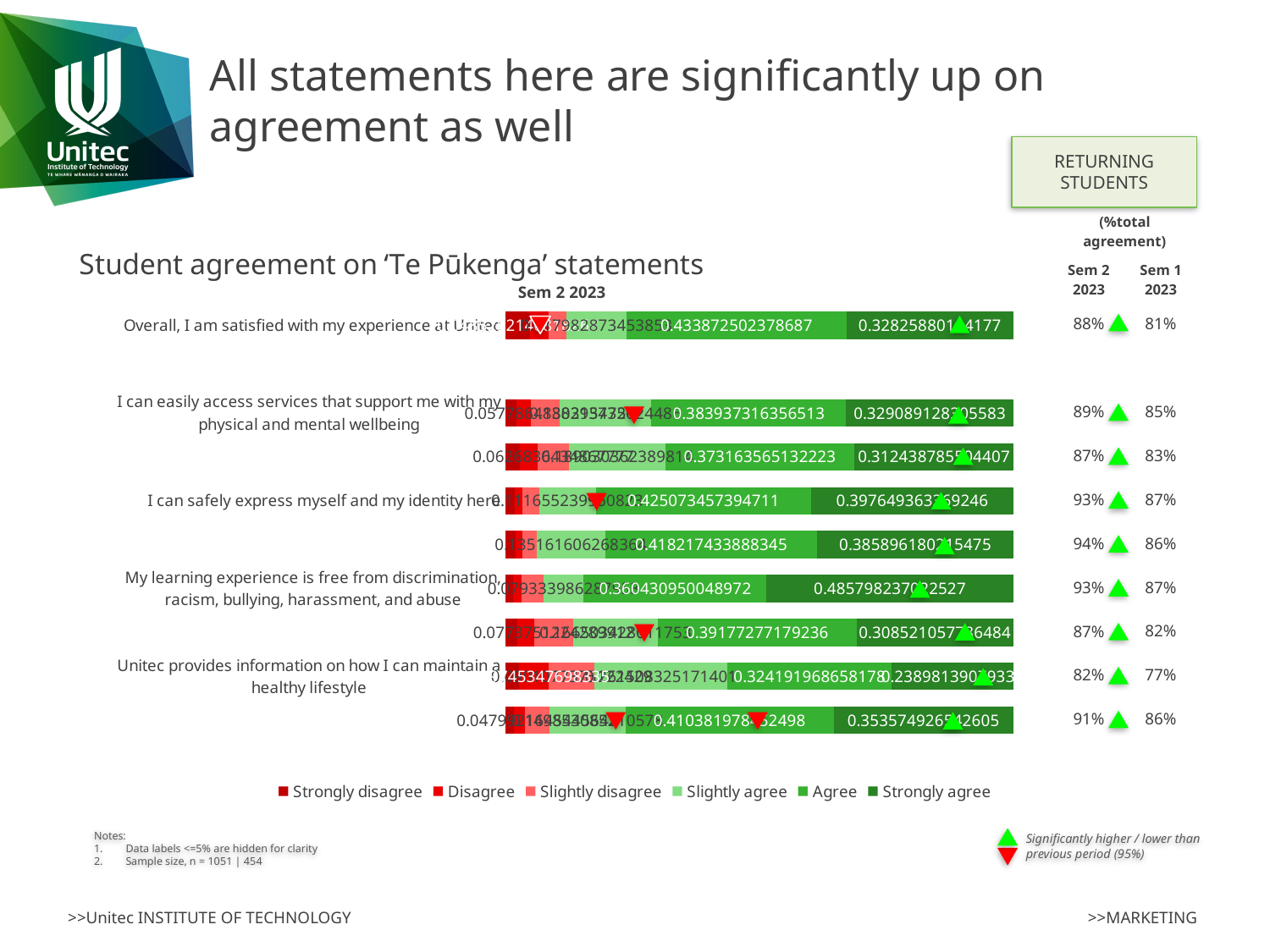
By how many percentage points did total agreement for 'Overall, I am satisfied with my experience at Unitec' change from Sem 1 2023 to Sem 2 2023? 7 percentage points Which labelled statement has the lowest Sem 2 2023 % total agreement? Unitec provides information on how I can maintain a healthy lifestyle What is the Sem 2 2023 % total agreement for 'I can safely express myself and my identity here'? 93% What is the Agree value shown on the bar for 'Overall, I am satisfied with my experience at Unitec'? 0.433872502378687 What is the Sem 1 2023 % total agreement for 'Overall, I am satisfied with my experience at Unitec'? 81% What type of chart is used to show student agreement on 'Te Pūkenga' statements? bar chart What is the Sem 2 2023 % total agreement for 'Overall, I am satisfied with my experience at Unitec'? 88% What is the Sem 2 2023 % total agreement for 'Unitec provides information on how I can maintain a healthy lifestyle'? 82% What title appears above the bars of the chart? Sem 2 2023 For 'I can easily access services that support me with my physical and mental wellbeing', which period has the higher % total agreement, Sem 2 2023 or Sem 1 2023? Sem 2 2023 How many series does the legend of the chart list? 6 What are the legend entries of the chart, from left to right? Strongly disagree, Disagree, Slightly disagree, Slightly agree, Agree, Strongly agree